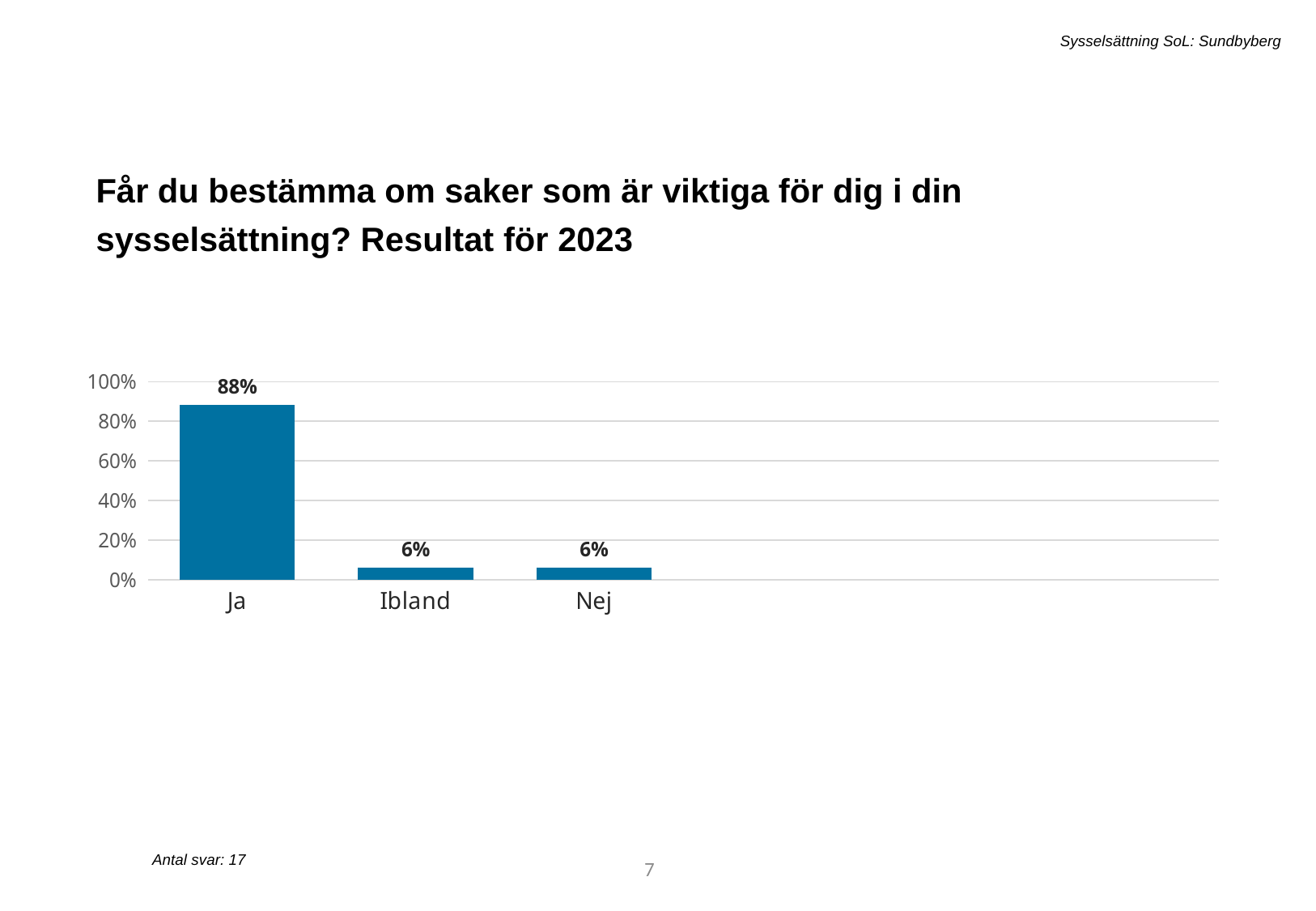
Is the value for Ja greater or less than 80%? greater How many categories are shown on the x axis? 3 What is the value for Ja? 88% What is the value for Ibland? 6% What is the difference between the values for Ja and Ibland? 82% Which category has the highest value? Ja Is the value for Nej greater or less than 20%? less How many responses (Antal svar) does the slide report? 17 What is the difference between the values for Ja and Nej? 82% Which is larger, the value for Ja or the value for Ibland? Ja What kind of chart is shown on the slide? bar chart What is the value for Nej? 6%